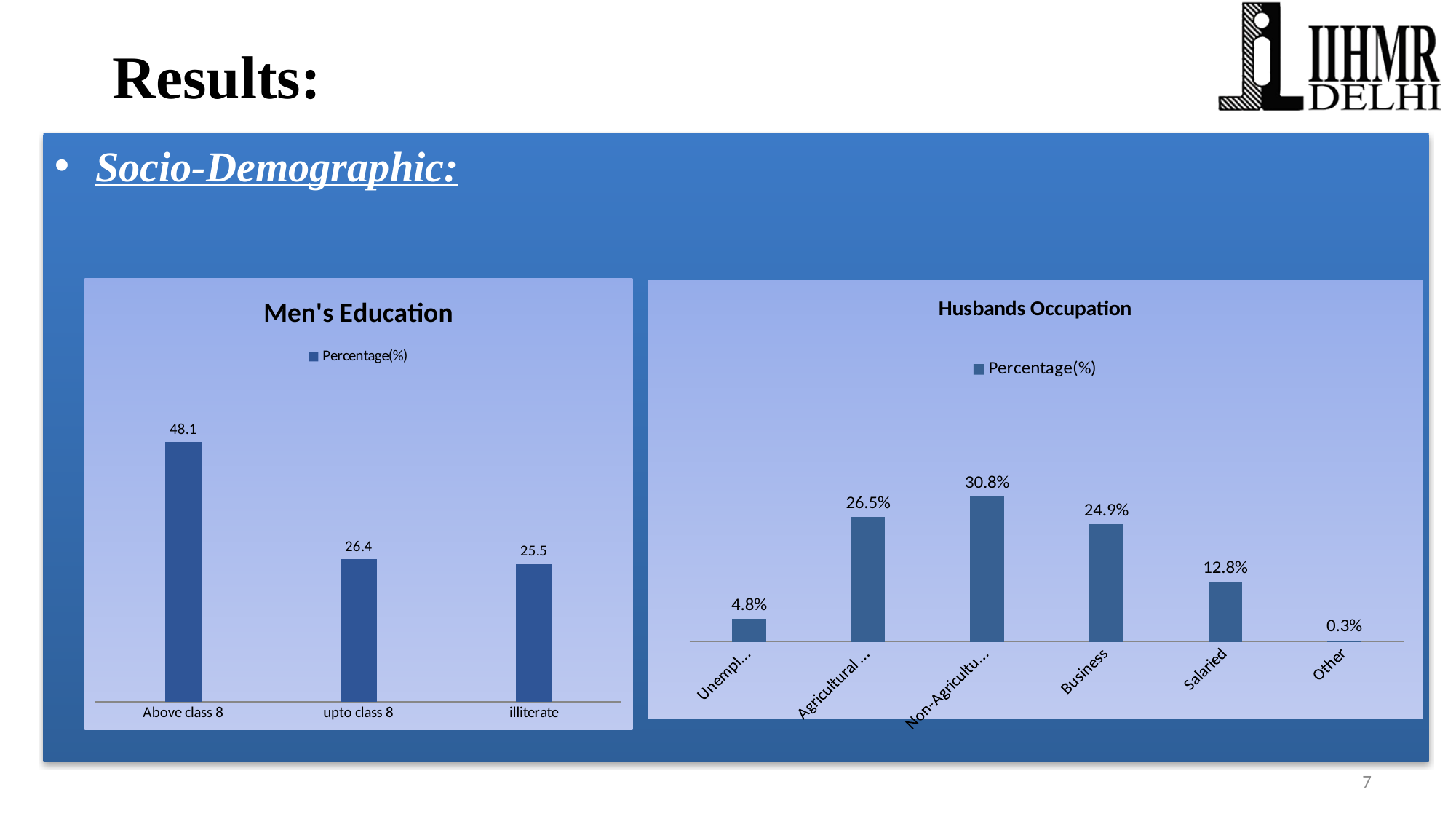
In the Men's Education chart, which category has the lowest value? illiterate In the Husbands Occupation chart, which category has the lowest value? Other In the Husbands Occupation chart, how many categories are shown? 6 In the Husbands Occupation chart, what is the value for Salaried? 12.8% What kind of chart is the Husbands Occupation chart? Bar chart In the Men's Education chart, what is the value for Above class 8? 48.1 In the Husbands Occupation chart, which is larger, Business or Salaried? Business In the Men's Education chart, which category has the highest value? Above class 8 In the Husbands Occupation chart, what is the value for Business? 24.9% In the Men's Education chart, what is the difference between the values for Above class 8 and illiterate? 22.6 In the Men's Education chart, what is the value for upto class 8? 26.4 In the Men's Education chart, how many categories are shown? 3